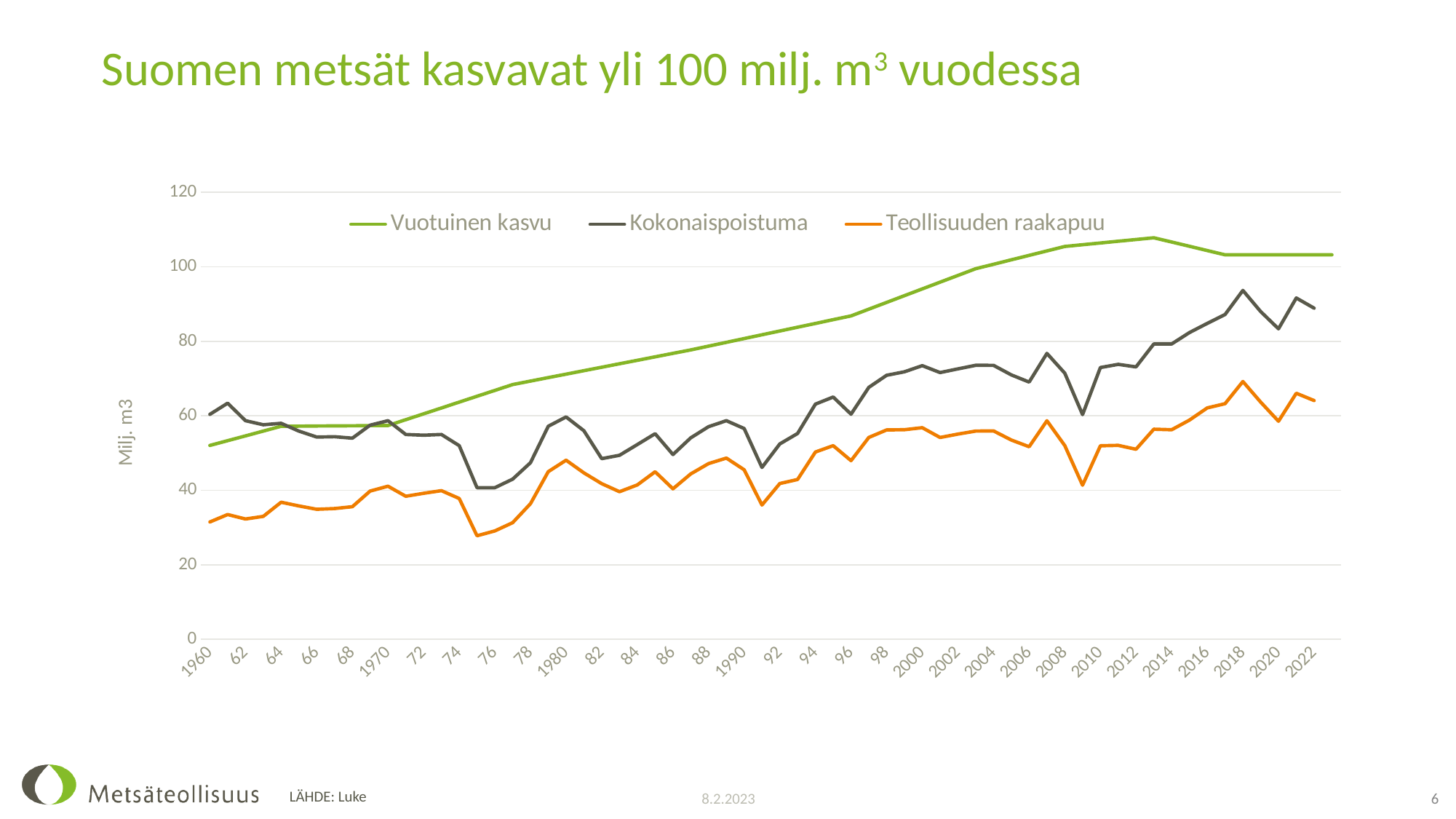
How many series does the legend list? 3 What kind of chart is shown on the slide? Line chart Is the value for Teollisuuden raakapuu in 1960 greater or less than 40? less What is the label on the vertical axis? Milj. m3 Is the value for Vuotuinen kasvu in 2022 greater or less than 100? greater Is the value for Kokonaispoistuma in 2018 greater or less than 80? greater In 1960, which is larger: Kokonaispoistuma or Vuotuinen kasvu? Kokonaispoistuma Which series has the lowest value in 1960? Teollisuuden raakapuu In 2022, which is larger: Vuotuinen kasvu or Kokonaispoistuma? Vuotuinen kasvu Which colour is used for the Teollisuuden raakapuu series? Orange Does the Vuotuinen kasvu series generally rise or fall from 1960 to 2022? Rise